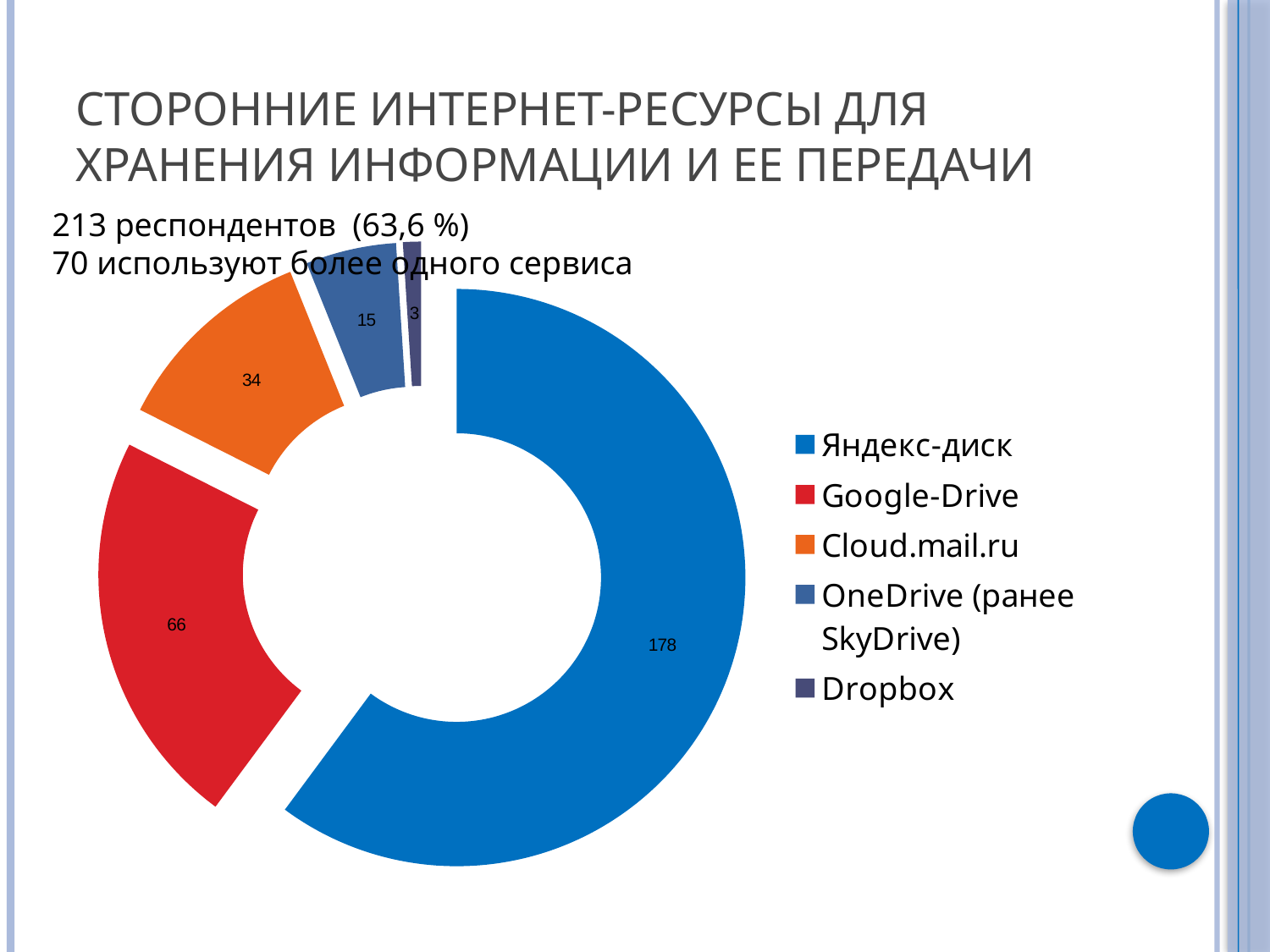
What kind of chart is shown on the slide? Doughnut chart What value is shown for Cloud.mail.ru? 34 What value is shown for OneDrive (ранее SkyDrive)? 15 What value is shown for Яндекс-диск? 178 Which service has the smallest value in the chart? Dropbox How many services are shown in the chart? 5 What colour is the segment for Google-Drive? Red Which is larger, the value for Cloud.mail.ru or the value for OneDrive (ранее SkyDrive)? Cloud.mail.ru What is the difference between the values for Яндекс-диск and Google-Drive? 112 What value is shown for Google-Drive? 66 What value is shown for Dropbox? 3 Which service has the largest value in the chart? Яндекс-диск